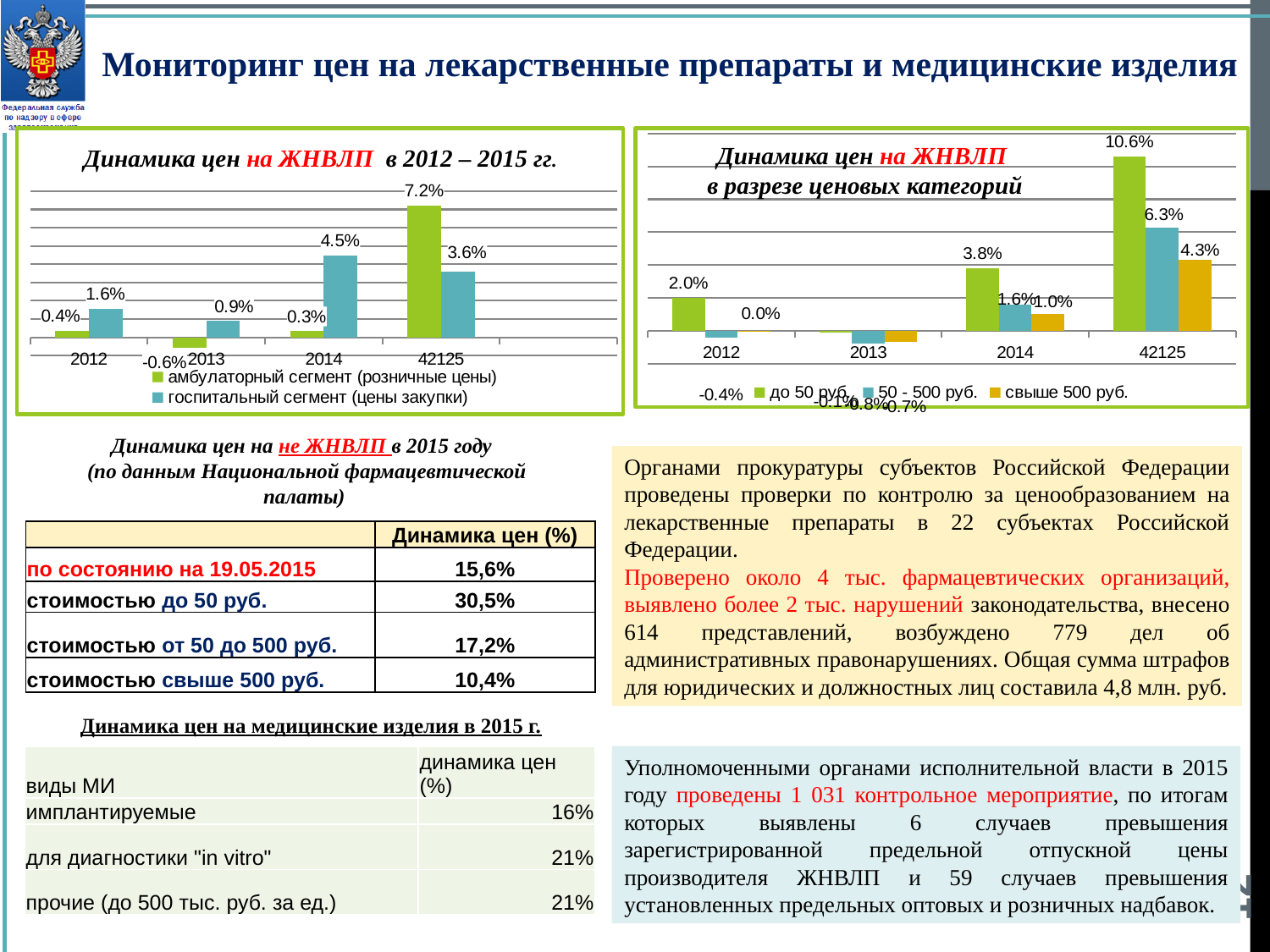
In the right chart 'Динамика цен на ЖНВЛП в разрезе ценовых категорий', which price category has the highest value in 2014? до 50 руб. How many series does the legend of the right chart 'Динамика цен на ЖНВЛП в разрезе ценовых категорий' list? 3 How many series does the legend of the left chart 'Динамика цен на ЖНВЛП в 2012 – 2015 гг.' list? 2 In the right chart 'Динамика цен на ЖНВЛП в разрезе ценовых категорий', what is the value for 'свыше 500 руб.' in 2014? 1.0% In the left chart 'Динамика цен на ЖНВЛП в 2012 – 2015 гг.', in which year is the амбулаторный сегмент value the lowest? 2013 In the left chart 'Динамика цен на ЖНВЛП в 2012 – 2015 гг.', what is the value for the амбулаторный сегмент in 2014? 0.3% In the left chart 'Динамика цен на ЖНВЛП в 2012 – 2015 гг.', what is the difference between the амбулаторный сегмент and госпитальный сегмент values for the last category (42125)? 3.6% In the right chart 'Динамика цен на ЖНВЛП в разрезе ценовых категорий', what is the value for 'до 50 руб.' in the last category (42125)? 10.6% In the left chart 'Динамика цен на ЖНВЛП в 2012 – 2015 гг.', which segment has the larger value in 2012? госпитальный сегмент (цены закупки) What kind of chart is the right chart 'Динамика цен на ЖНВЛП в разрезе ценовых категорий'? bar chart In the left chart 'Динамика цен на ЖНВЛП в 2012 – 2015 гг.', what is the value for the госпитальный сегмент in 2014? 4.5% In the right chart 'Динамика цен на ЖНВЛП в разрезе ценовых категорий', what is the difference between the 'до 50 руб.' and '50 - 500 руб.' values in the last category (42125)? 4.3%